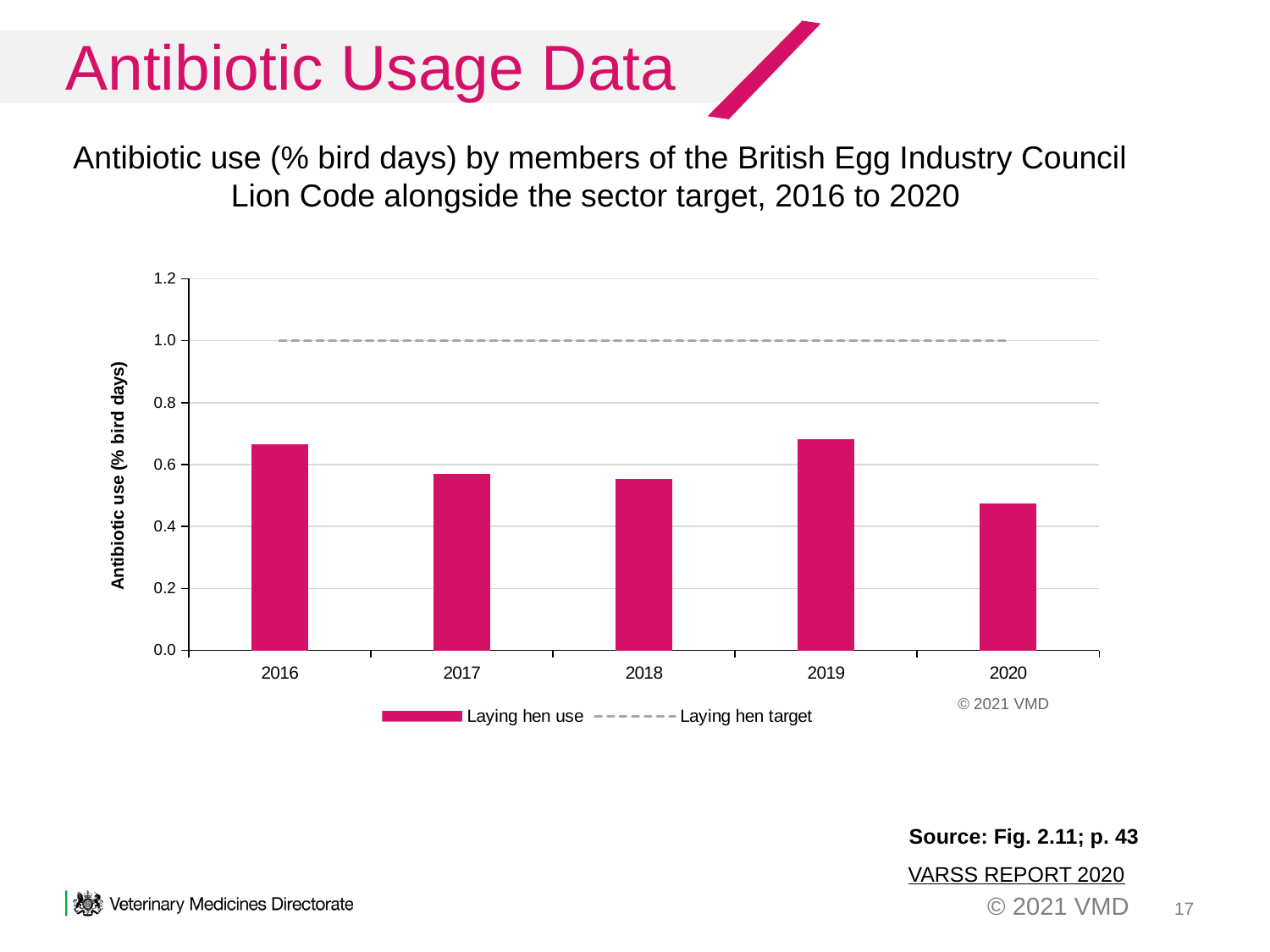
Which year has the higher laying hen use, 2016 or 2020? 2016 What is the value of the laying hen target line? 1.0 Which year has the lowest laying hen use? 2020 Does the laying hen use rise or fall from 2019 to 2020? fall What is the label of the y axis of the chart? Antibiotic use (% bird days) How many years are shown on the x axis of the chart? 5 Is the laying hen use for 2019 greater or less than 0.6? greater Is the laying hen use for 2016 greater or less than 0.6? greater Is the laying hen use for 2018 greater or less than 0.8? less How many series does the chart legend list? 2 What type of chart is shown on the slide? bar chart